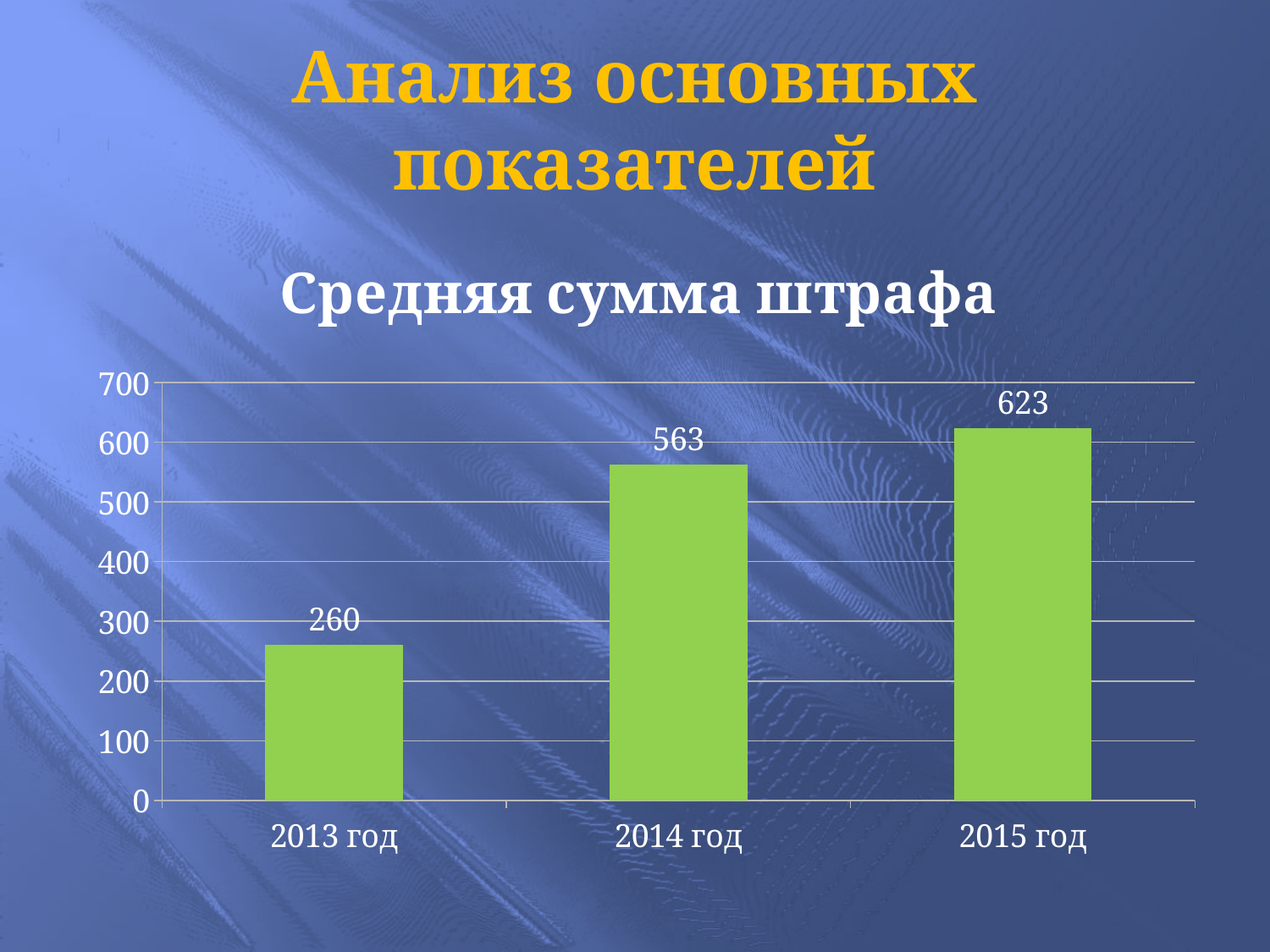
What is the difference between the values for 2014 год and 2013 год? 303 What is the value for 2013 год? 260 Which year has the lowest average fine? 2013 год Is the value for 2015 год greater or less than 600? greater What is the value for 2014 год? 563 How many categories are shown on the x axis? 3 What is the value for 2015 год? 623 Do the values rise or fall from 2013 год to 2015 год? rise Which year has the highest average fine? 2015 год What is the difference between the values for 2015 год and 2014 год? 60 Which is larger, the value for 2013 год or the value for 2014 год? 2014 год What kind of chart is shown on the slide? bar chart